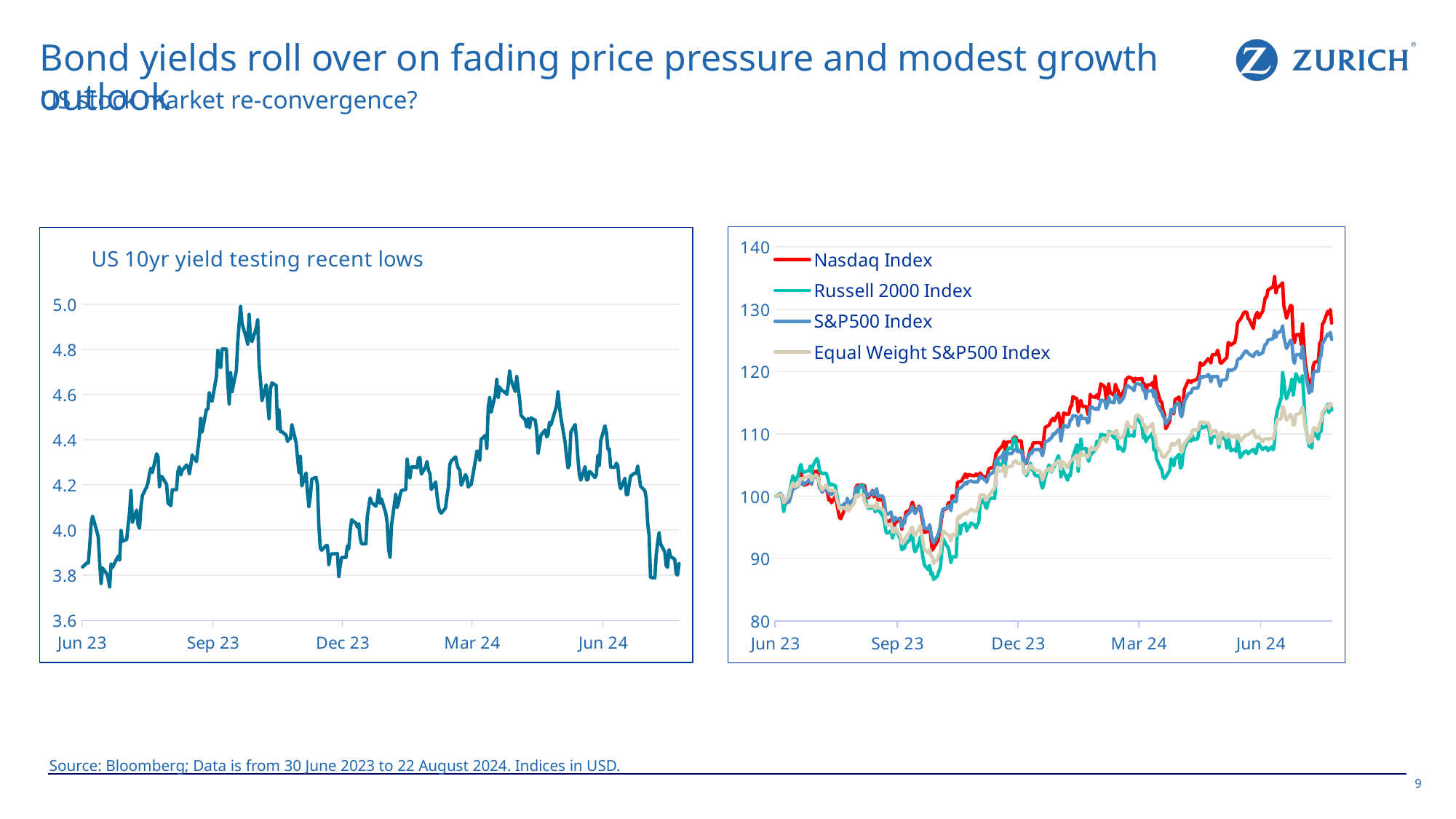
In the right chart, is the peak value of the Nasdaq Index greater or less than 130? greater In the left chart, does the US 10yr yield rise or fall between its peak in autumn 2023 and Dec 23? fall In the left chart, is the US 10yr yield at Jun 23 greater or less than 4.0? less In the right chart, is the Nasdaq Index at Jun 24 greater or less than 120? greater In the right chart, which index has the lowest value around Oct 2023? Russell 2000 Index How many series does the legend of the right chart list? 4 What is the title of the left chart? US 10yr yield testing recent lows In the right chart, which colour is the Nasdaq Index line? red What kind of chart is the left chart titled 'US 10yr yield testing recent lows'? line chart In the right chart, which index has the highest value at the end of the period? Nasdaq Index